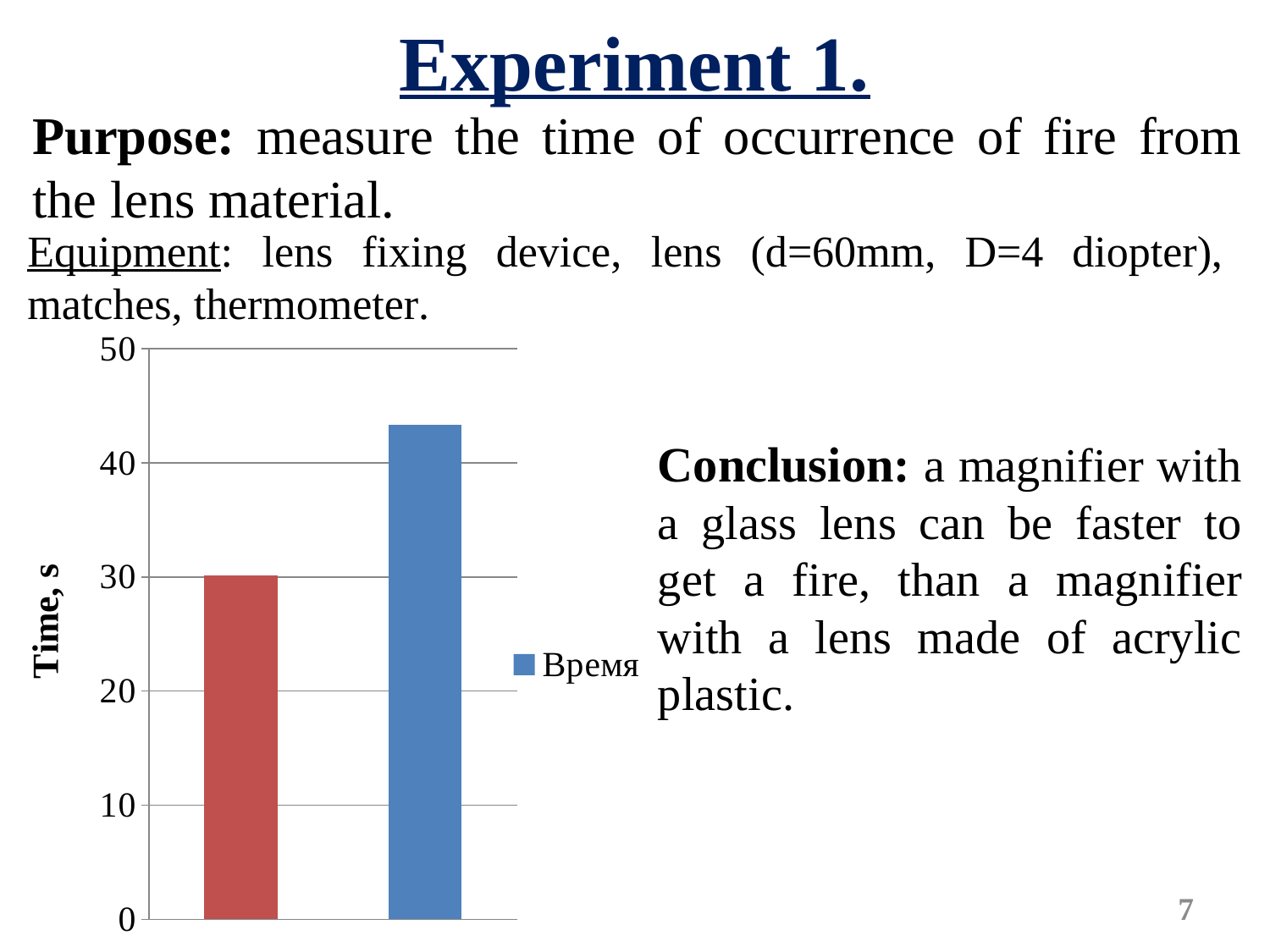
Is the value for the blue bar on the right greater or less than 50? less What kind of chart is shown on the slide? bar chart Is the value for the blue bar on the right greater or less than 40? greater Which bar is taller, the red bar on the left or the blue bar on the right? the blue bar on the right What is the legend entry shown next to the chart? Время How many bars are plotted in the chart? 2 Which bar shows the lowest time value? the red bar on the left Which bar shows the highest time value? the blue bar on the right What is the title of the vertical axis of the chart? Time, s How many series does the chart legend list? 1 Is the value for the red bar on the left greater or less than 40? less